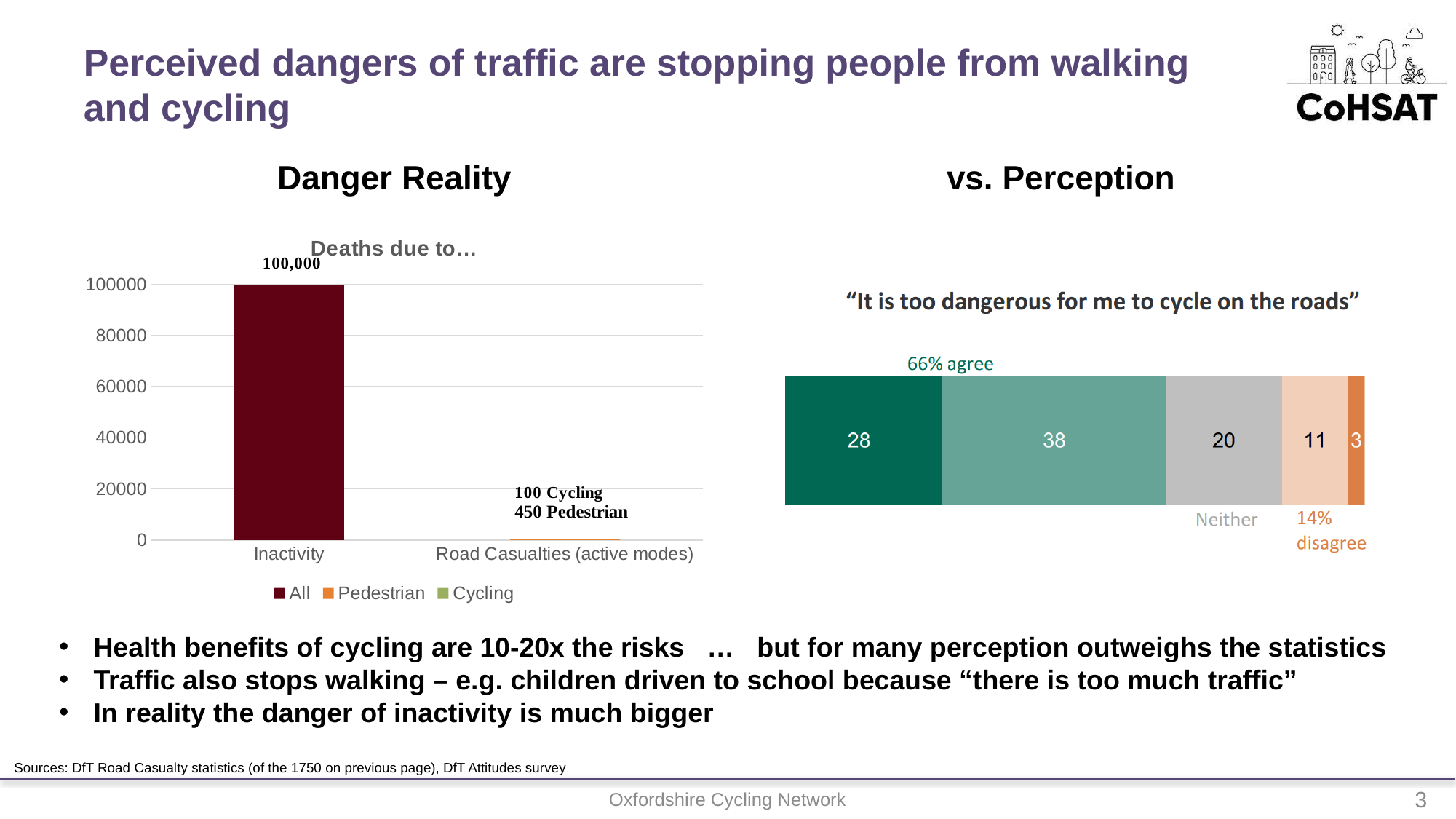
In the "It is too dangerous for me to cycle on the roads" chart, what is the value of the Neither segment? 20 In the "Deaths due to…" chart, how many Pedestrian deaths are labelled under Road Casualties (active modes)? 450 In the "Deaths due to…" chart, which is larger under Road Casualties: Pedestrian or Cycling deaths? Pedestrian In the "Deaths due to…" chart, how many series does the legend list? 3 In the "Deaths due to…" chart, how many Cycling deaths are labelled under Road Casualties (active modes)? 100 In the "It is too dangerous for me to cycle on the roads" chart, what percentage agree? 66% In the "Deaths due to…" chart, how many categories are shown on the x axis? 2 In the "It is too dangerous for me to cycle on the roads" chart, what is the value of the largest segment? 38 In the "Deaths due to…" chart, what is the value shown for Inactivity? 100,000 In the "Deaths due to…" chart, what is the difference between Pedestrian and Cycling deaths under Road Casualties? 350 In the "It is too dangerous for me to cycle on the roads" chart, what is the total of all the segments in the stacked bar? 100 What kind of chart is the "Deaths due to…" chart? Bar chart